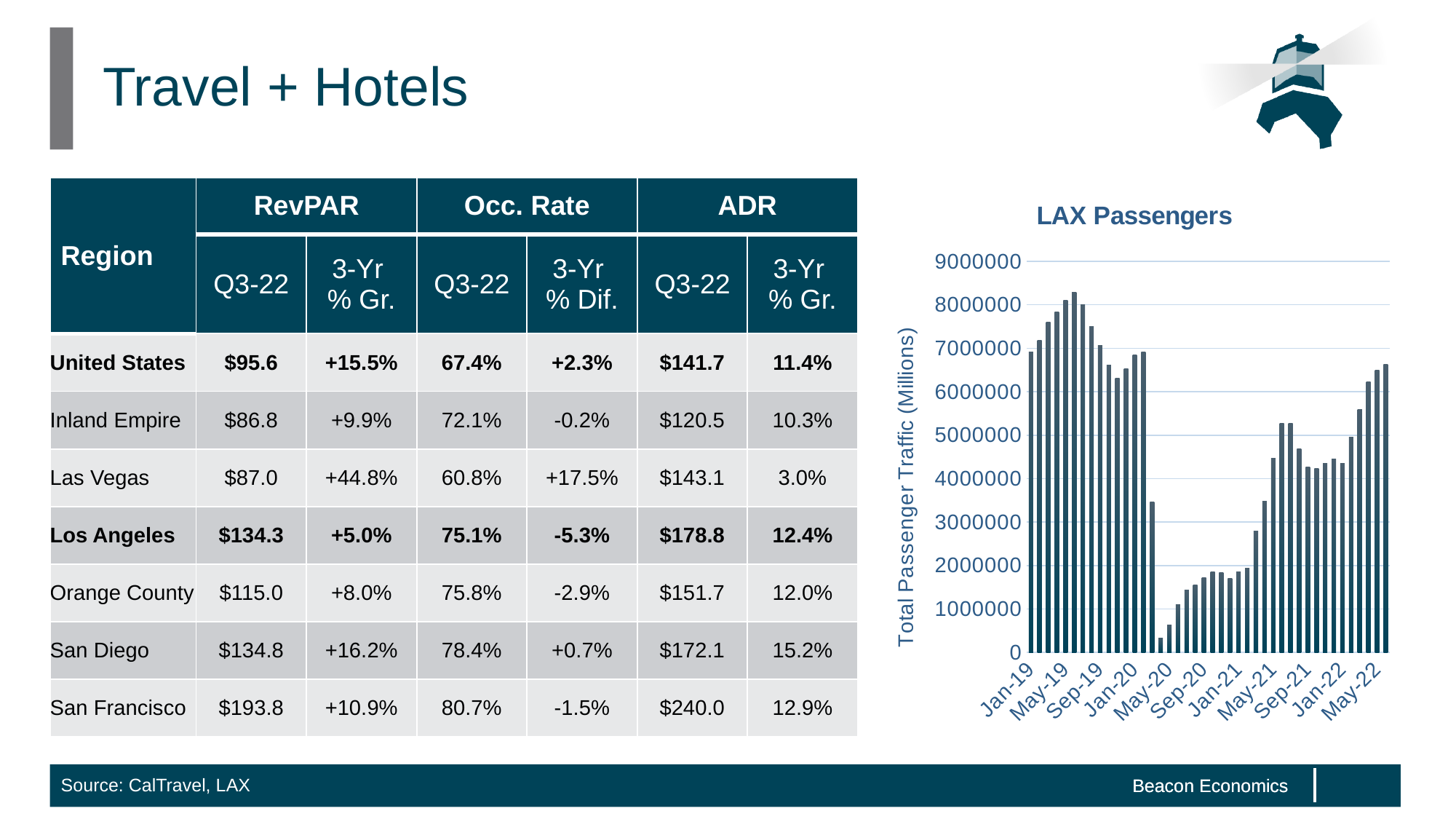
In the LAX Passengers chart, is the value for May-22 greater or less than 5000000? greater In the LAX Passengers chart, do the values rise or fall from Jan-20 to May-20? fall In the LAX Passengers chart, is the value for Sep-20 greater or less than 3000000? less What kind of chart is the LAX Passengers chart? bar chart What is the label on the vertical axis of the LAX Passengers chart? Total Passenger Traffic (Millions) In the LAX Passengers chart, which is larger, the value for Jan-19 or the value for Jan-21? Jan-19 In the LAX Passengers chart, is the value for Jan-19 greater or less than 6000000? greater In the LAX Passengers chart, which is larger, the value for May-19 or the value for May-20? May-19 In the LAX Passengers chart, do the values rise or fall from Jan-21 to May-21? rise What is the title of the chart on the slide? LAX Passengers